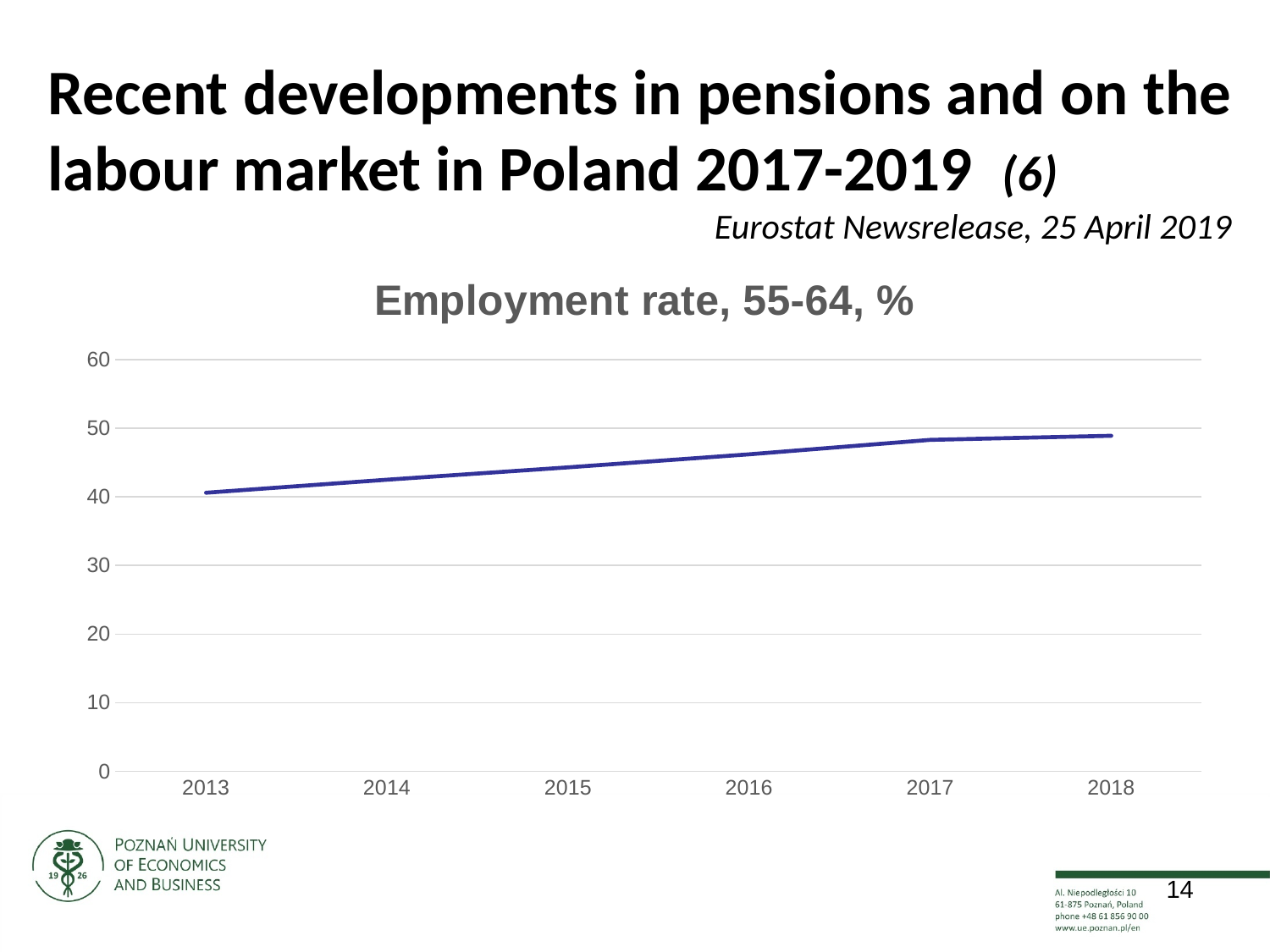
What kind of chart is shown on the slide? line chart What is the first year shown on the x axis of the chart? 2013 Does the employment rate rise or fall from 2013 to 2018? rise Is the employment rate for 2016 greater or less than 40? greater Is the employment rate for 2018 greater or less than 60? less What is the title of the chart? Employment rate, 55-64, % Is the employment rate for 2015 greater or less than 30? greater Which year has the larger employment rate, 2013 or 2016? 2016 Which year has the larger employment rate, 2014 or 2017? 2017 Which year has the lowest employment rate in the chart? 2013 How many years are plotted on the x axis of the chart? 6